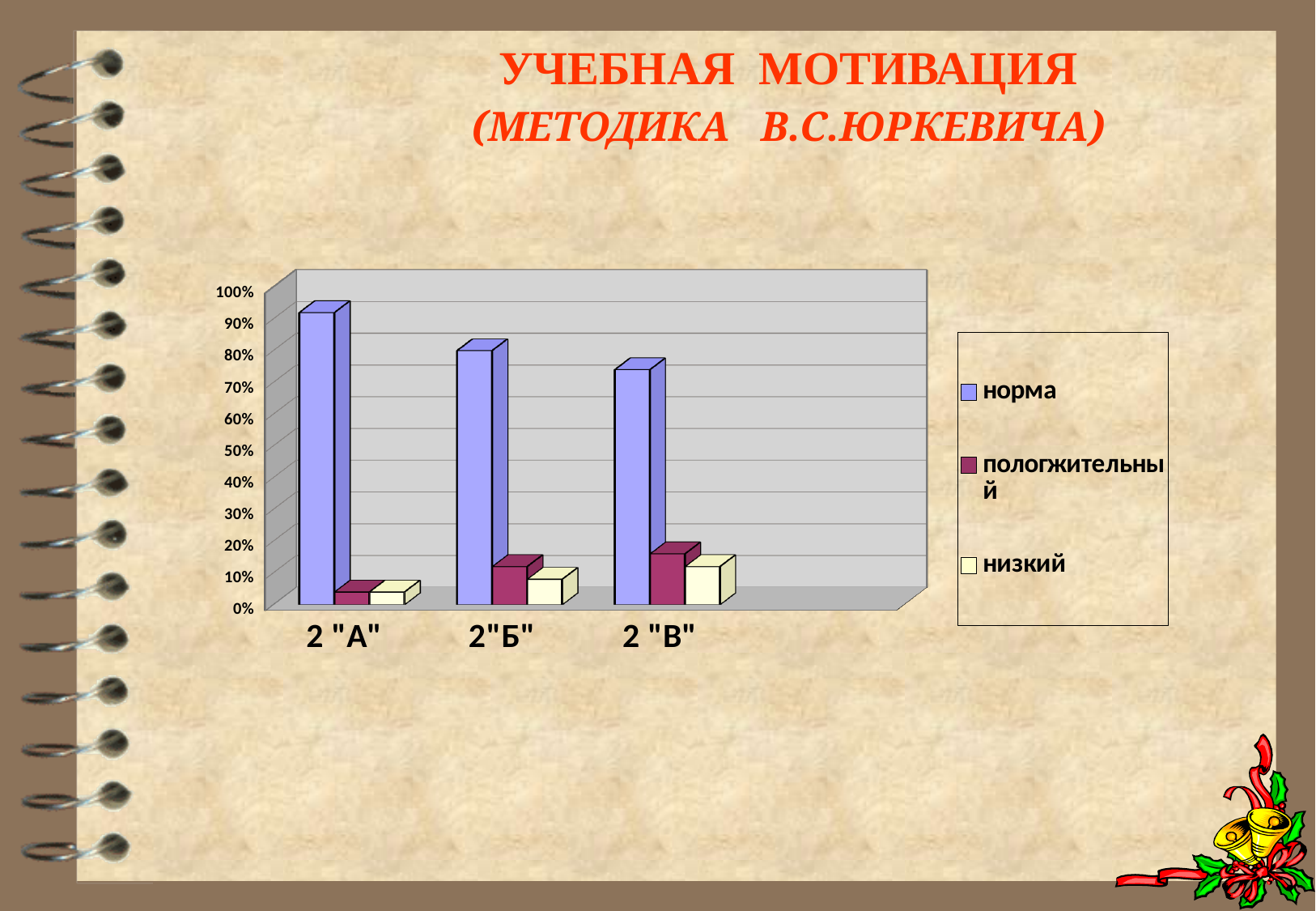
Is the value of "низкий" for 2 "А" greater or less than 10%? less How many categories (classes) are shown on the x axis of the chart? 3 What kind of chart is shown on the slide? bar chart Which class has the lowest value for the series "норма"? 2 "В" Which class has the highest value for the series "норма"? 2 "А" Which is larger: the "пологжительный" value for 2 "В" or for 2 "А"? 2 "В" How many series does the chart legend list? 3 Do the values of the "норма" series rise or fall from 2 "А" to 2 "В" along the x axis? fall Is the value of "норма" for 2 "А" greater or less than 80%? greater Which is larger: the "норма" value for 2 "А" or for 2"Б"? 2 "А" Is the value of "норма" for 2 "В" greater or less than 80%? less Which series is shown in blue in the chart legend? норма